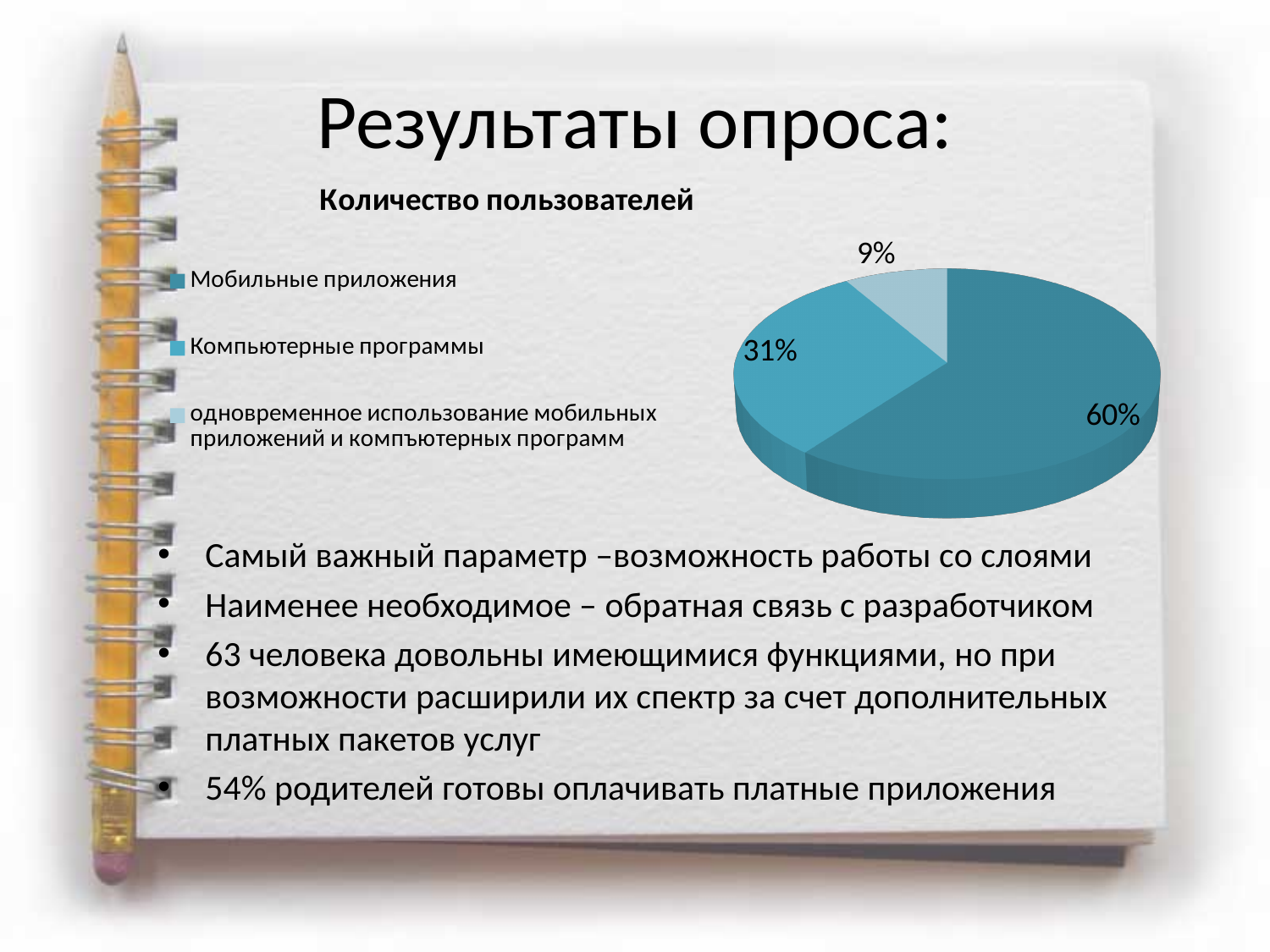
What is the difference in percentage points between Мобильные приложения and Компьютерные программы? 29 What share of the pie is labelled for Мобильные приложения? 60% What share of the pie is labelled for одновременное использование мобильных приложений и компъютерных программ? 9% How many entries does the legend list? 3 What type of chart is shown on the slide? Pie chart What is the title of the chart? Количество пользователей Which category has the largest slice of the pie? Мобильные приложения What share of the pie is labelled for Компьютерные программы? 31% Which is larger: the share for Компьютерные программы or the share for одновременное использование мобильных приложений и компъютерных программ? Компьютерные программы Which category has the smallest slice of the pie? одновременное использование мобильных приложений и компъютерных программ Which legend entry is shown in the lightest colour? одновременное использование мобильных приложений и компъютерных программ How many slices does the pie chart have? 3